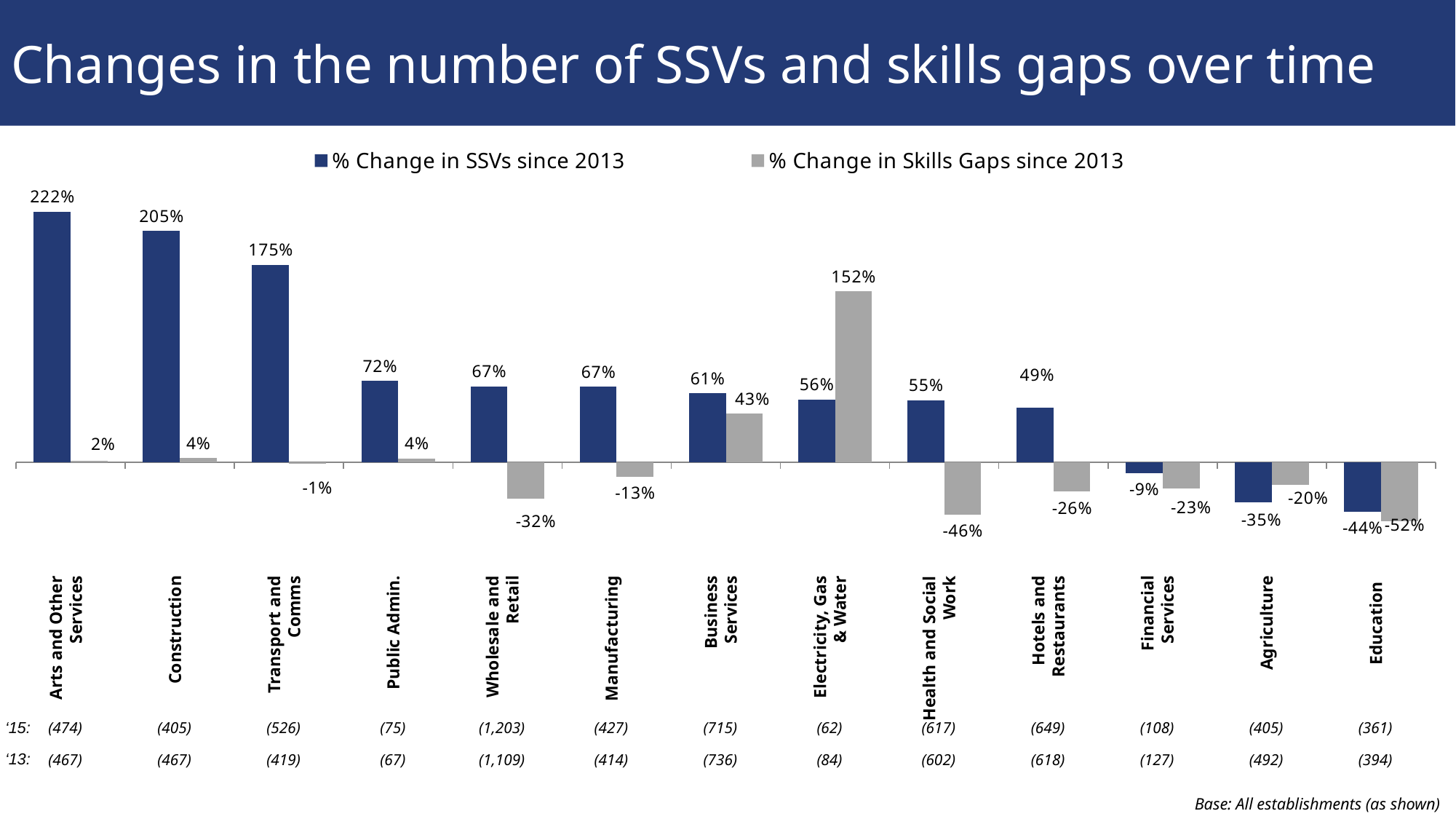
Which is larger for Business Services: the % change in SSVs since 2013 or the % change in Skills Gaps since 2013? % Change in SSVs since 2013 Which colour represents the % Change in Skills Gaps since 2013 series? Grey What is the % change in Skills Gaps since 2013 for Wholesale and Retail? -32% What is the % change in Skills Gaps since 2013 for Electricity, Gas & Water? 152% What is the % change in SSVs since 2013 for Construction? 205% What is the difference between the % change in SSVs since 2013 for Arts and Other Services and for Transport and Comms? 47 percentage points How many sectors are shown on the x axis of the chart? 13 Which sector has the lowest % change in Skills Gaps since 2013? Education Which sector has the highest % change in SSVs since 2013? Arts and Other Services What kind of chart is shown on the slide? Bar chart Do the % change in SSVs since 2013 values rise or fall moving from left to right across the sectors? Fall How many series does the legend list? 2